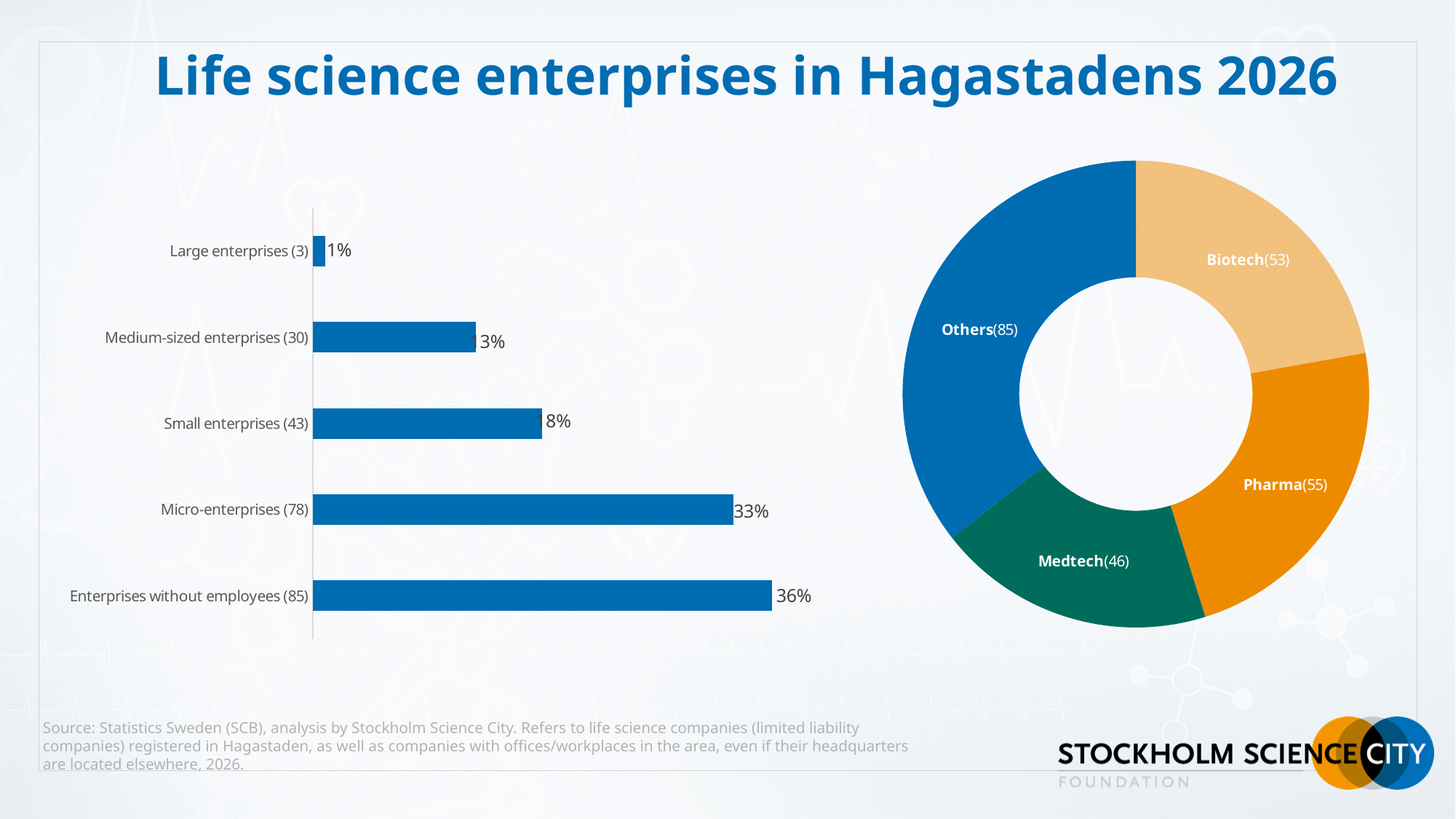
How many categories does the bar chart on the left show? 5 On the bar chart on the left, which is larger: the percentage for Small enterprises or for Medium-sized enterprises? Small enterprises What kind of chart is on the left side of the slide? Bar chart On the bar chart on the left, which category has the lowest percentage? Large enterprises On the donut chart on the right, what is the difference between the Others count and the Biotech count? 32 On the bar chart on the left, what is the difference in percentage points between Enterprises without employees and Small enterprises? 18 On the donut chart on the right, which segment has the smallest count? Medtech On the donut chart on the right, which segment has the largest count? Others On the donut chart on the right, how many enterprises are in the Pharma segment? 55 On the bar chart on the left, which category has the highest percentage? Enterprises without employees On the bar chart on the left, what percentage is shown for Medium-sized enterprises? 13% On the bar chart on the left, what percentage is shown for Micro-enterprises? 33%